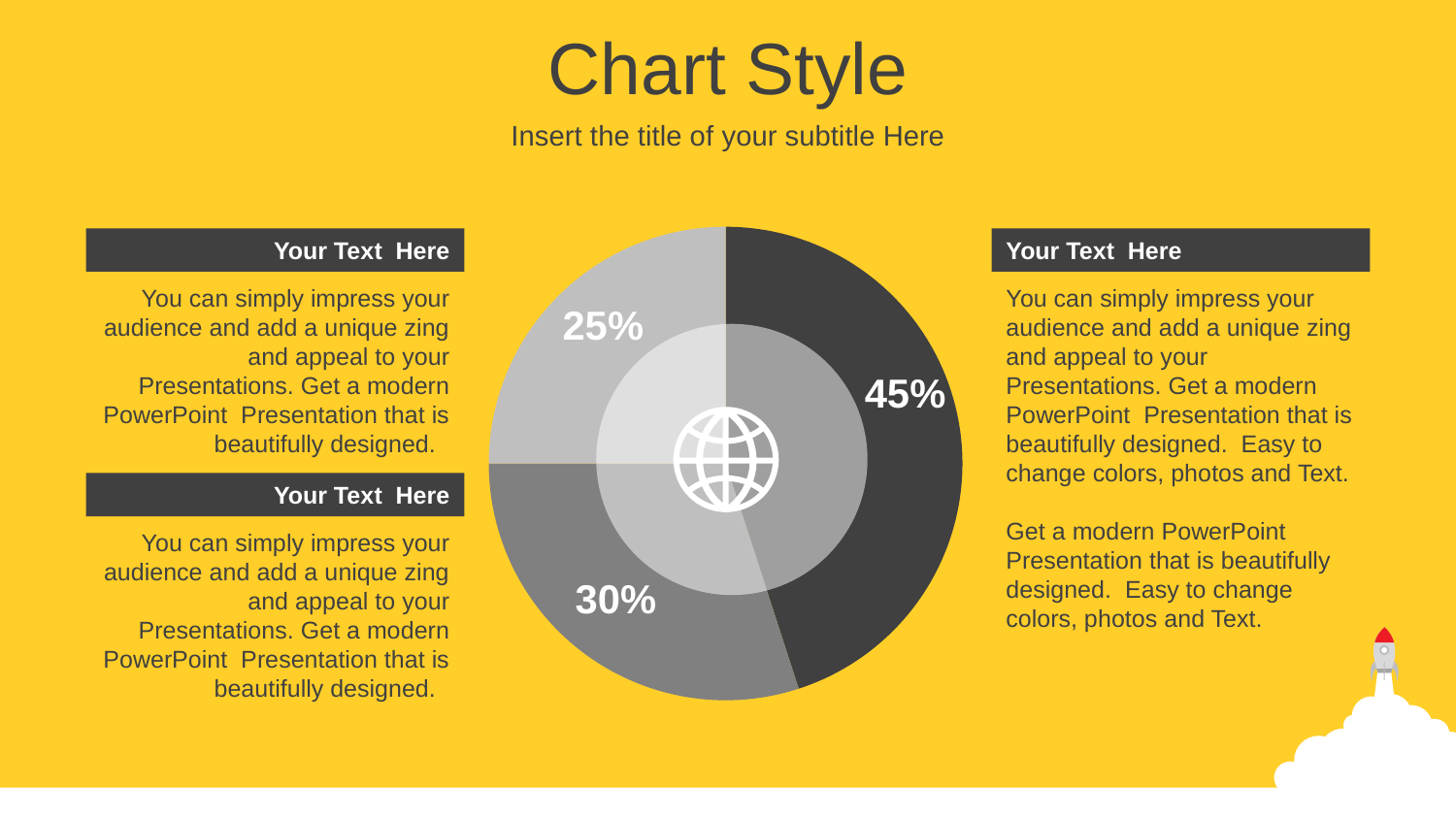
What percentage is labelled on the darkest slice of the pie chart? 45% What do the three slice percentages in the pie chart add up to? 100% What is the title of the slide containing the pie chart? Chart Style What is the largest share shown in the pie chart? 45% What percentage is labelled on the medium-gray slice at the bottom left of the pie chart? 30% What is the smallest share shown in the pie chart? 25% How many slices does the pie chart have? 3 What percentage is labelled on the lightest slice of the pie chart? 25% What is the difference between the largest and smallest slices of the pie chart? 20% What is the difference between the 45% slice and the 30% slice? 15% What kind of chart is shown on the slide? pie chart Which is larger, the slice labelled 30% or the slice labelled 25%? 30%